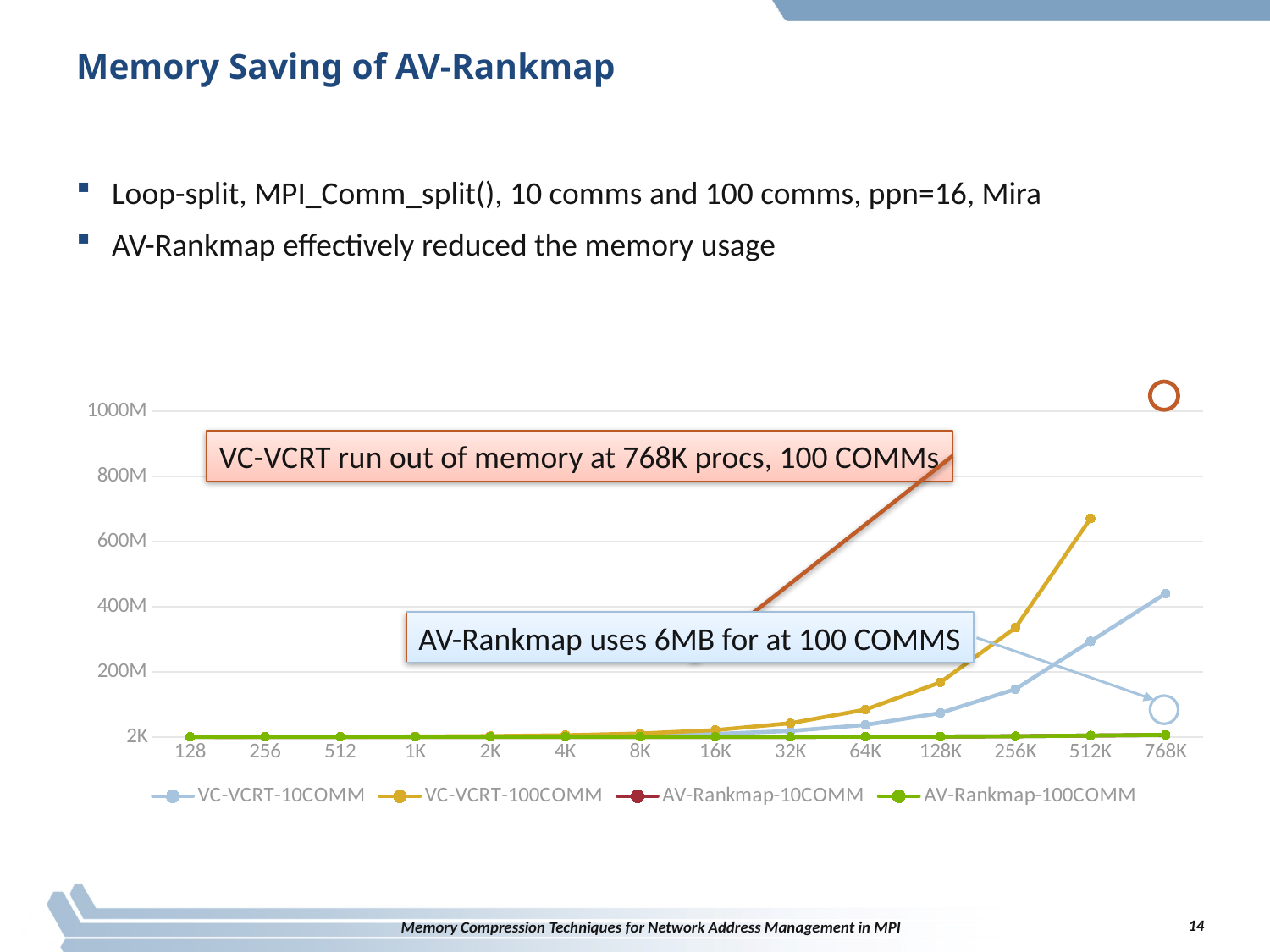
Is the value for VC-VCRT-10COMM at 512K greater or less than 400M? less How many series does the chart legend list? 4 Is the value for VC-VCRT-100COMM at 512K greater or less than 600M? greater What kind of chart is shown on the slide? line chart According to the annotation on the chart, at how many procs did VC-VCRT run out of memory with 100 COMMs? 768K At 512K, which series has the larger value: VC-VCRT-10COMM or VC-VCRT-100COMM? VC-VCRT-100COMM How many process-count categories are shown on the x axis of the chart? 14 Is the value for VC-VCRT-10COMM at 768K greater or less than 400M? greater What is the last entry listed in the chart legend? AV-Rankmap-100COMM Does the VC-VCRT-10COMM series rise or fall as the process count increases along the x axis? rise Which series reaches the highest memory value on the chart? VC-VCRT-100COMM